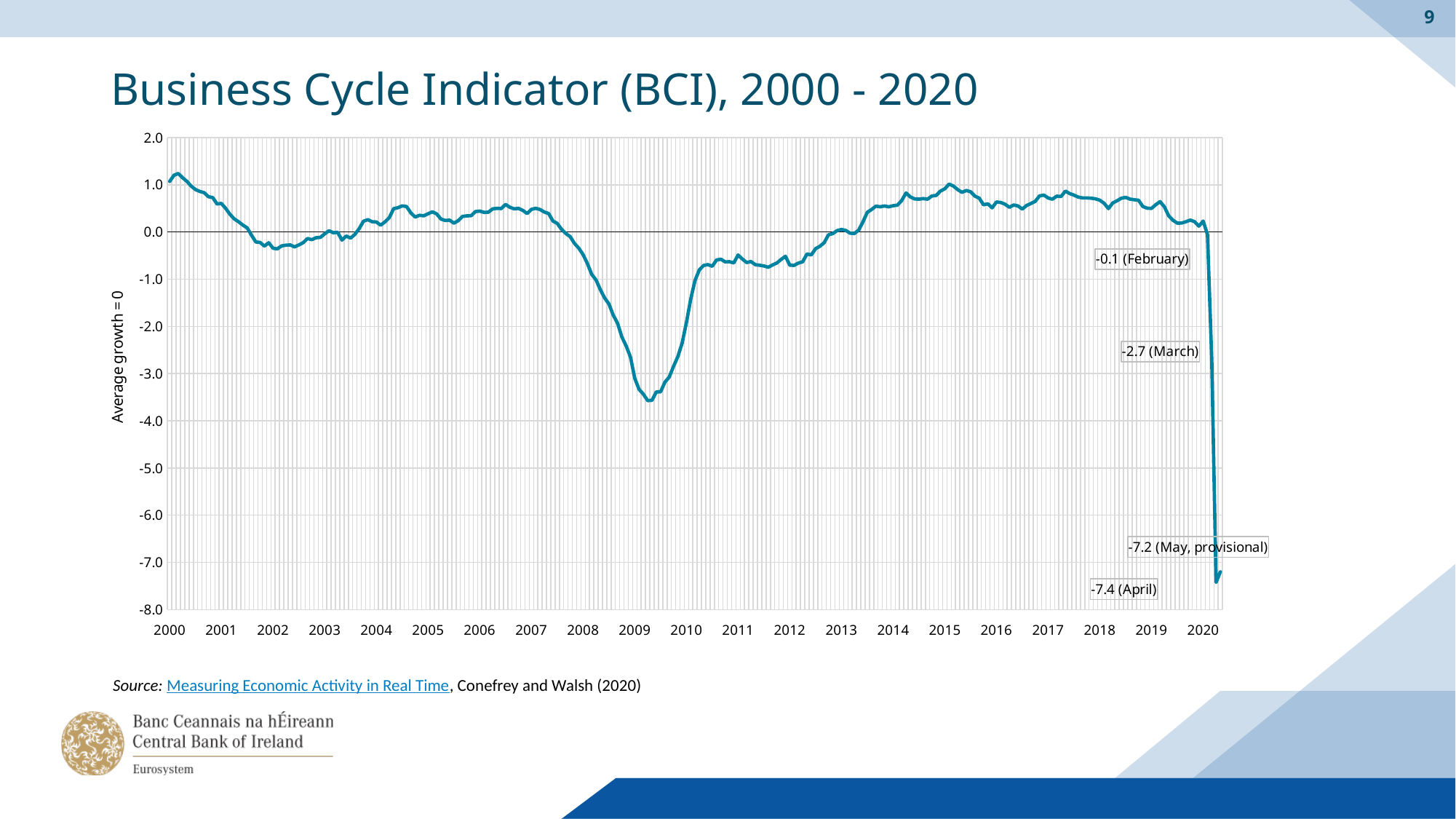
Does the BCI rise or fall between the start of 2008 and early 2009? fall What is the provisional BCI value labelled for May 2020? -7.2 What is the difference between the labelled February 2020 value and the labelled March 2020 value? 2.6 What is the BCI value labelled for March 2020? -2.7 Which labelled month in 2020 has the lowest BCI value? April Is the lowest point of the BCI around 2009 greater or less than -3.0? less What is the difference between the labelled March 2020 value and the labelled April 2020 value? 4.7 What kind of chart is shown on the slide? line chart What is the BCI value labelled for April 2020? -7.4 What is the label on the vertical axis of the chart? Average growth = 0 What is the BCI value labelled for February 2020? -0.1 Which is larger, the labelled April 2020 value or the labelled May 2020 provisional value? May 2020 provisional (-7.2)